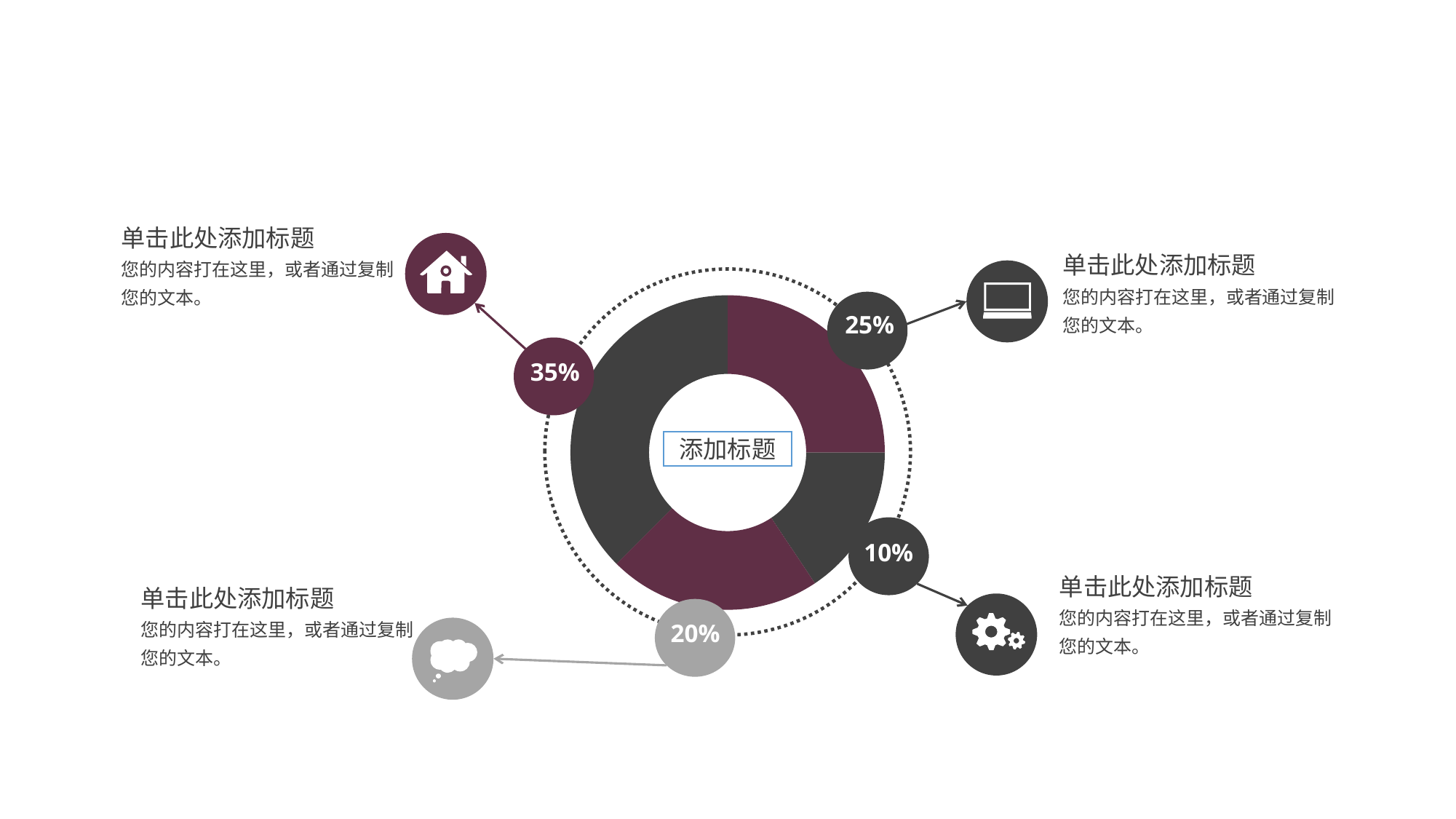
How many segments does the donut chart have? 4 What kind of chart is shown on the slide? Donut (pie) chart What percentage is shown in the bubble linked to the thought-bubble icon? 20% Which percentage is the largest shown on the donut chart? 35% What percentage is shown in the bubble linked to the laptop icon? 25% Which is larger, the percentage linked to the laptop icon or the percentage linked to the thought-bubble icon? Laptop icon (25%) What percentage is shown in the bubble linked to the gears icon? 10% Which percentage is the smallest shown on the donut chart? 10% What text appears in the centre of the donut chart? 添加标题 What is the sum of the four percentages shown on the donut chart? 90% What is the difference between the largest and smallest percentages on the chart? 25 percentage points What percentage is shown in the bubble linked to the house icon? 35%